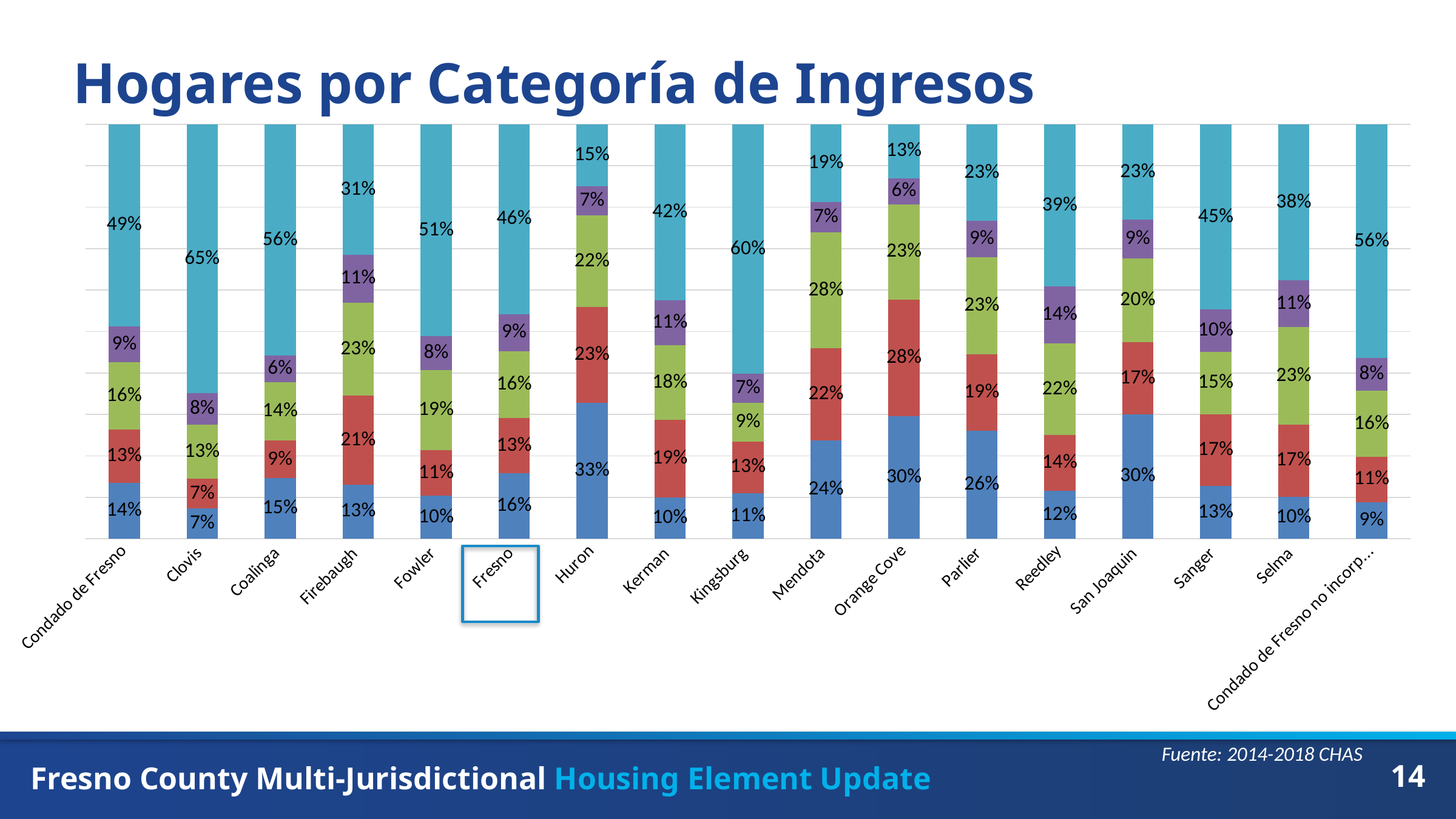
Which has a larger bottom (dark blue) segment value, Huron or Mendota? Huron What is the value of the red segment of the bar for Orange Cove? 28% What is the value of the green segment of the bar for Mendota? 28% What type of chart is shown on the slide? Stacked bar chart What is the value of the purple segment of the bar for Reedley? 14% What is the difference between the top (light blue) segment values for Clovis and Fresno? 19 percentage points What is the value of the bottom (dark blue) segment of the bar for Huron? 33% What is the value of the top (light blue) segment of the bar for Clovis? 65% Which category has the lowest value for the top (light blue) segment? Orange Cove Which category has the highest value for the top (light blue) segment? Clovis How many categories (jurisdictions) are shown along the x axis of the chart? 17 What is the title of the chart on the slide? Hogares por Categoría de Ingresos